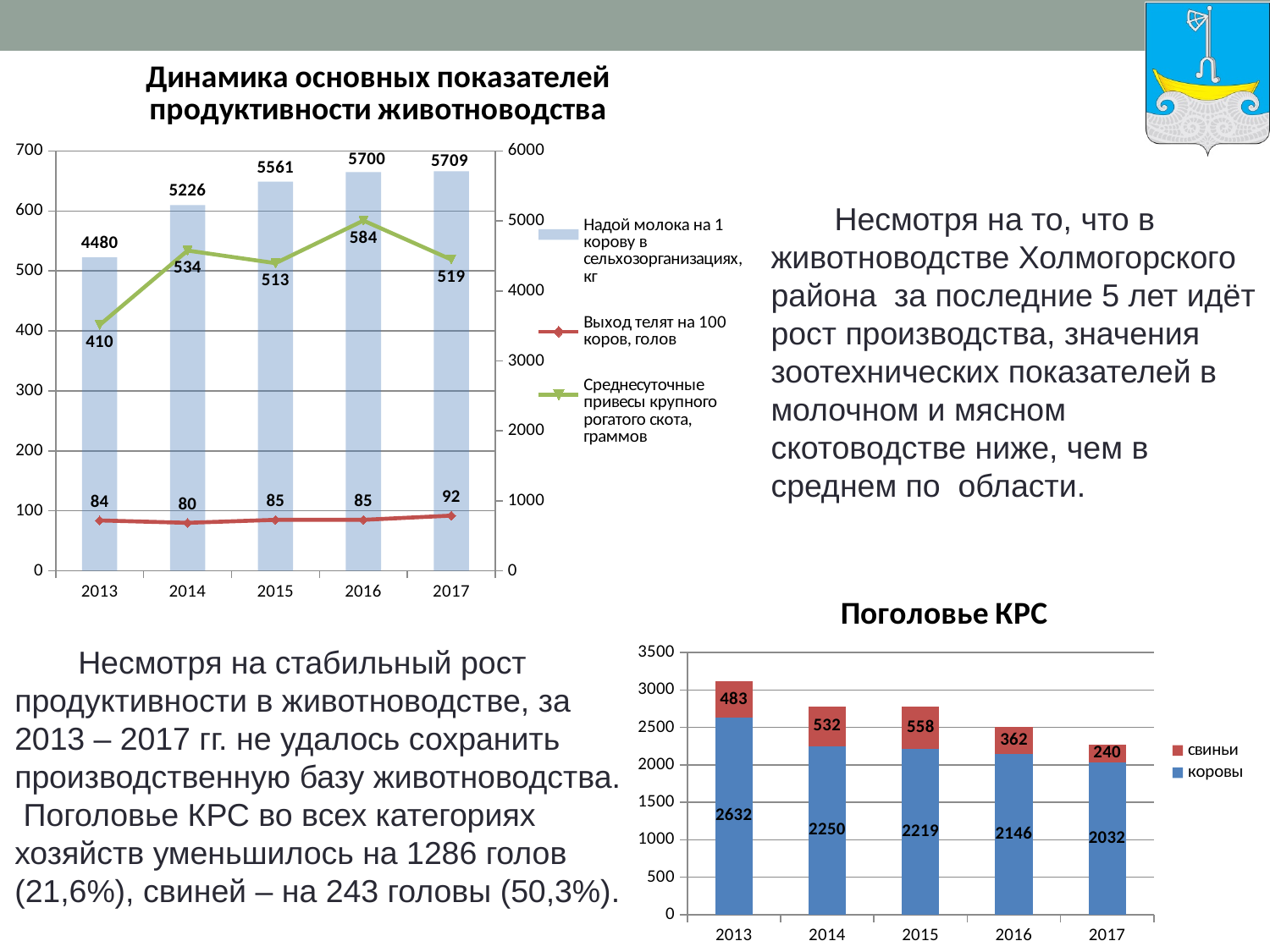
In the chart 'Динамика основных показателей продуктивности животноводства', in which year is 'Выход телят на 100 коров, голов' the highest? 2017 In the chart 'Поголовье КРС', what is the value for 'коровы' in 2017? 2032 What kind of chart is 'Поголовье КРС'? stacked bar chart In the chart 'Динамика основных показателей продуктивности животноводства', what is the difference between the 'Среднесуточные привесы' values for 2016 and 2015? 71 In the chart 'Поголовье КРС', what is the value for 'свиньи' in 2015? 558 In the chart 'Поголовье КРС', which is larger: 'свиньи' in 2014 or 'свиньи' in 2016? 2014 In the chart 'Динамика основных показателей продуктивности животноводства', in which year is 'Надой молока на 1 корову в сельхозорганизациях, кг' the lowest? 2013 In the chart 'Динамика основных показателей продуктивности животноводства', how many series does the legend list? 3 In the chart 'Динамика основных показателей продуктивности животноводства', does 'Надой молока на 1 корову' rise or fall from 2013 to 2017? rise In the chart 'Поголовье КРС', what is the total of the stacked bar for 2013? 3115 In the chart 'Динамика основных показателей продуктивности животноводства', what is the value of 'Среднесуточные привесы крупного рогатого скота, граммов' for 2013? 410 In the chart 'Динамика основных показателей продуктивности животноводства', what is the value of 'Надой молока на 1 корову в сельхозорганизациях, кг' for 2016? 5700